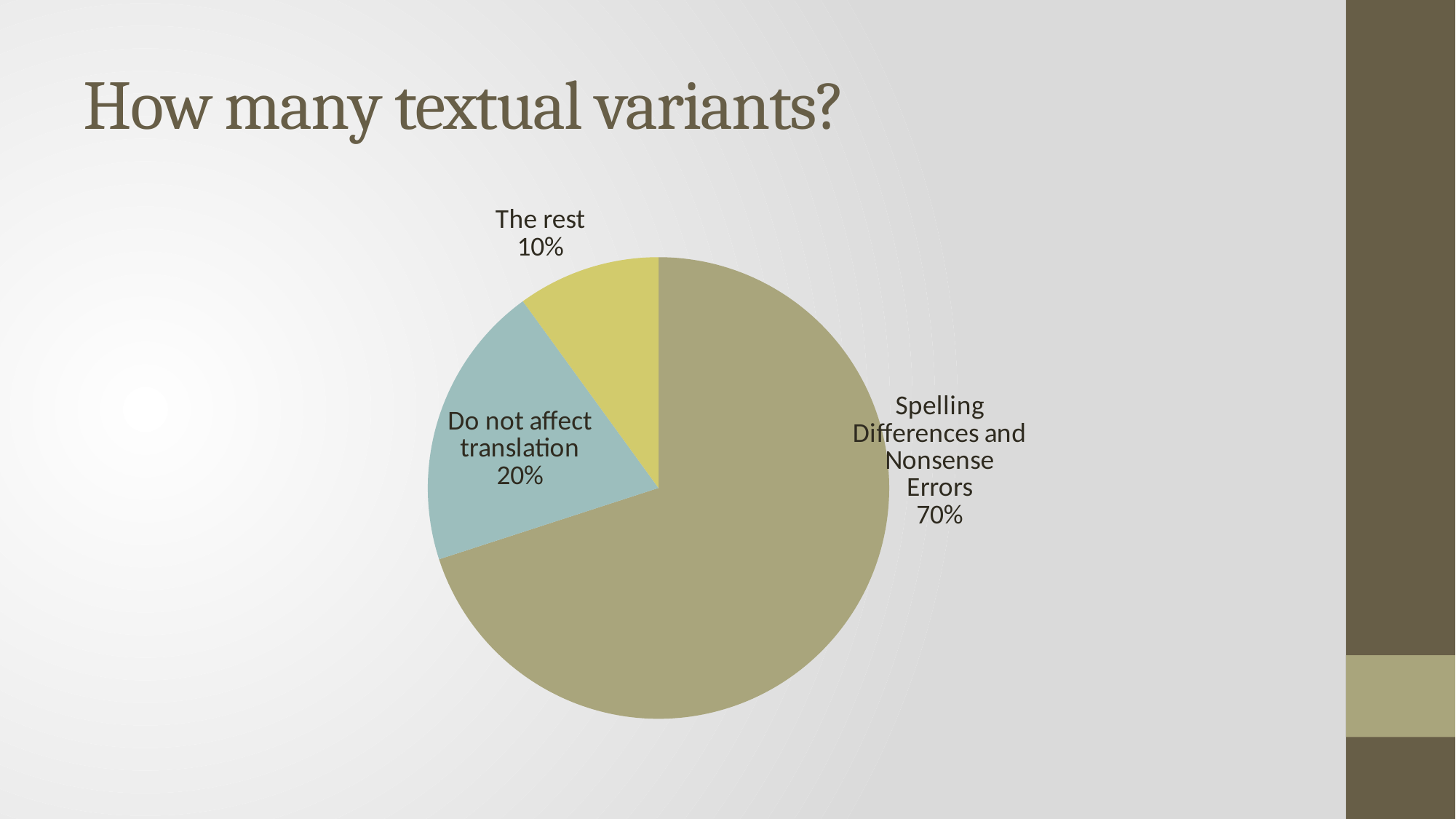
Which slice of the pie is the largest? Spelling Differences and Nonsense Errors Which is larger: the slice for "Do not affect translation" or the slice for "The rest"? Do not affect translation What is the title of the slide containing the pie chart? How many textual variants? How many slices does the pie chart have? 3 What share of the pie is labelled "Spelling Differences and Nonsense Errors"? 70% Which slice of the pie is the smallest? The rest What kind of chart is shown on the slide? pie chart What is the difference in percentage points between "Do not affect translation" and "The rest"? 10 What is the difference in percentage points between "Spelling Differences and Nonsense Errors" and "Do not affect translation"? 50 What share of the pie is labelled "The rest"? 10% What colour is the slice for "The rest"? yellow What share of the pie is labelled "Do not affect translation"? 20%